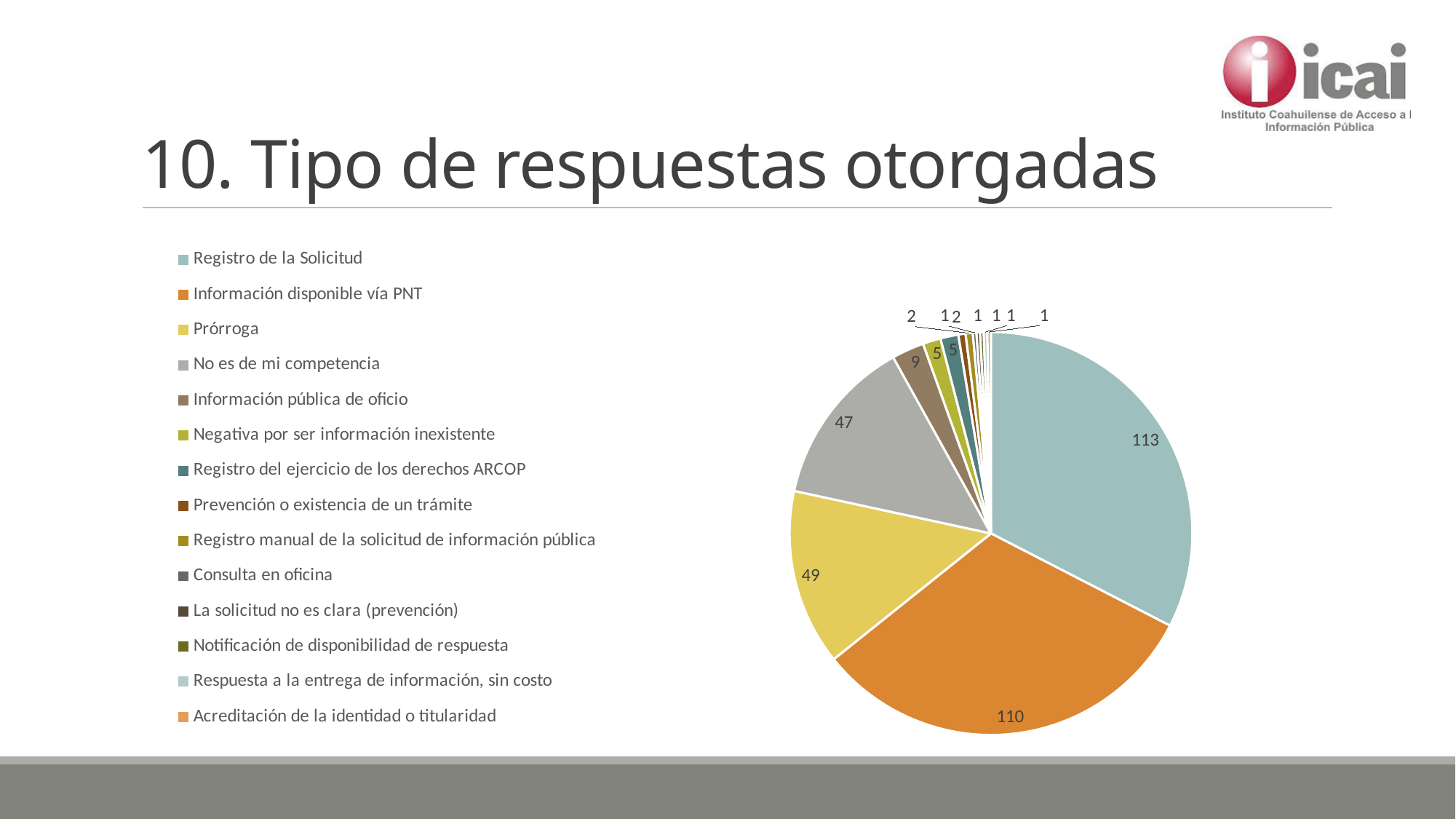
What is the difference between the values for Prórroga and No es de mi competencia? 2 What is the value for No es de mi competencia? 47 What type of chart is shown on the slide? pie chart Which is larger, the value for Prórroga or the value for No es de mi competencia? Prórroga What is the value for Información disponible vía PNT? 110 Which category has the largest slice of the pie? Registro de la Solicitud What is the value for Negativa por ser información inexistente? 5 What is the value for Prórroga? 49 How many categories does the legend list? 14 What is the value for Información pública de oficio? 9 What is the difference between the values for Registro de la Solicitud and Información disponible vía PNT? 3 What is the value for Registro de la Solicitud? 113